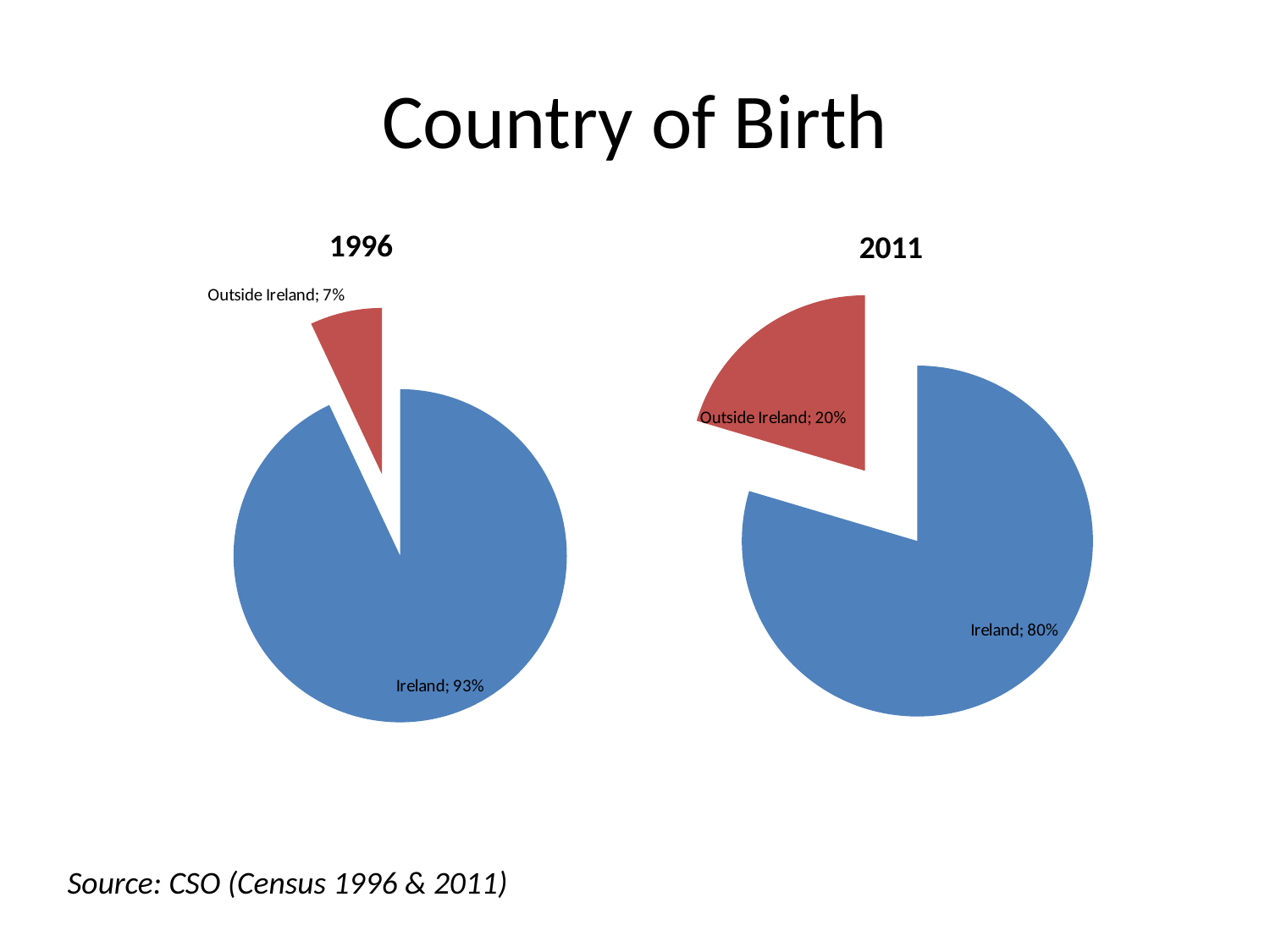
In the 2011 chart, which category has the smallest slice? Outside Ireland What is the title of the slide containing the two charts? Country of Birth In the 1996 chart, which category has the largest slice? Ireland What kind of chart is the 1996 chart? Pie chart How many slices does the 2011 chart have? 2 In the 2011 chart, what share of the pie is Outside Ireland? 20% In the 1996 chart, what is the difference between the Ireland and Outside Ireland shares? 86% In the 1996 chart, what share of the pie is Ireland? 93% In the 2011 chart, what share of the pie is Ireland? 80% Which chart shows a larger share for Outside Ireland, 1996 or 2011? 2011 In the 2011 chart, what is the difference between the Ireland and Outside Ireland shares? 60%